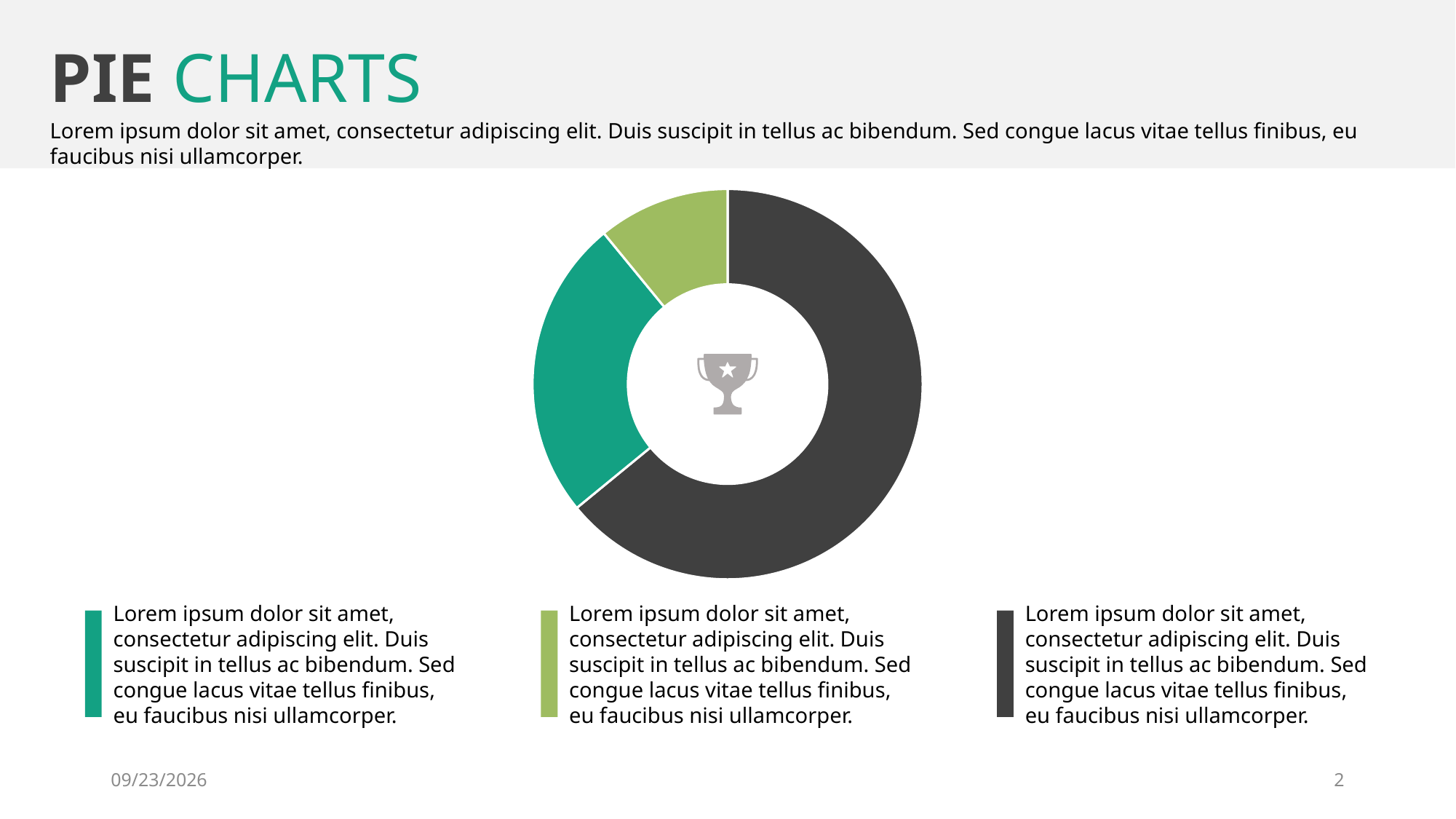
What kind of chart is shown on the slide? Doughnut (pie) chart Which colour slice is the smallest in the doughnut chart? Light green Does the dark gray slice take up more or less than half of the doughnut chart? More How many slices does the doughnut chart have? 3 Which slice is larger, the dark gray slice or the teal slice? Dark gray What icon appears in the centre of the doughnut chart? A trophy Which colour slice is the largest in the doughnut chart? Dark gray Which slice is larger, the teal slice or the light green slice? Teal Does the light green slice take up more or less than a quarter of the doughnut chart? Less What is the title of the slide containing the chart? PIE CHARTS